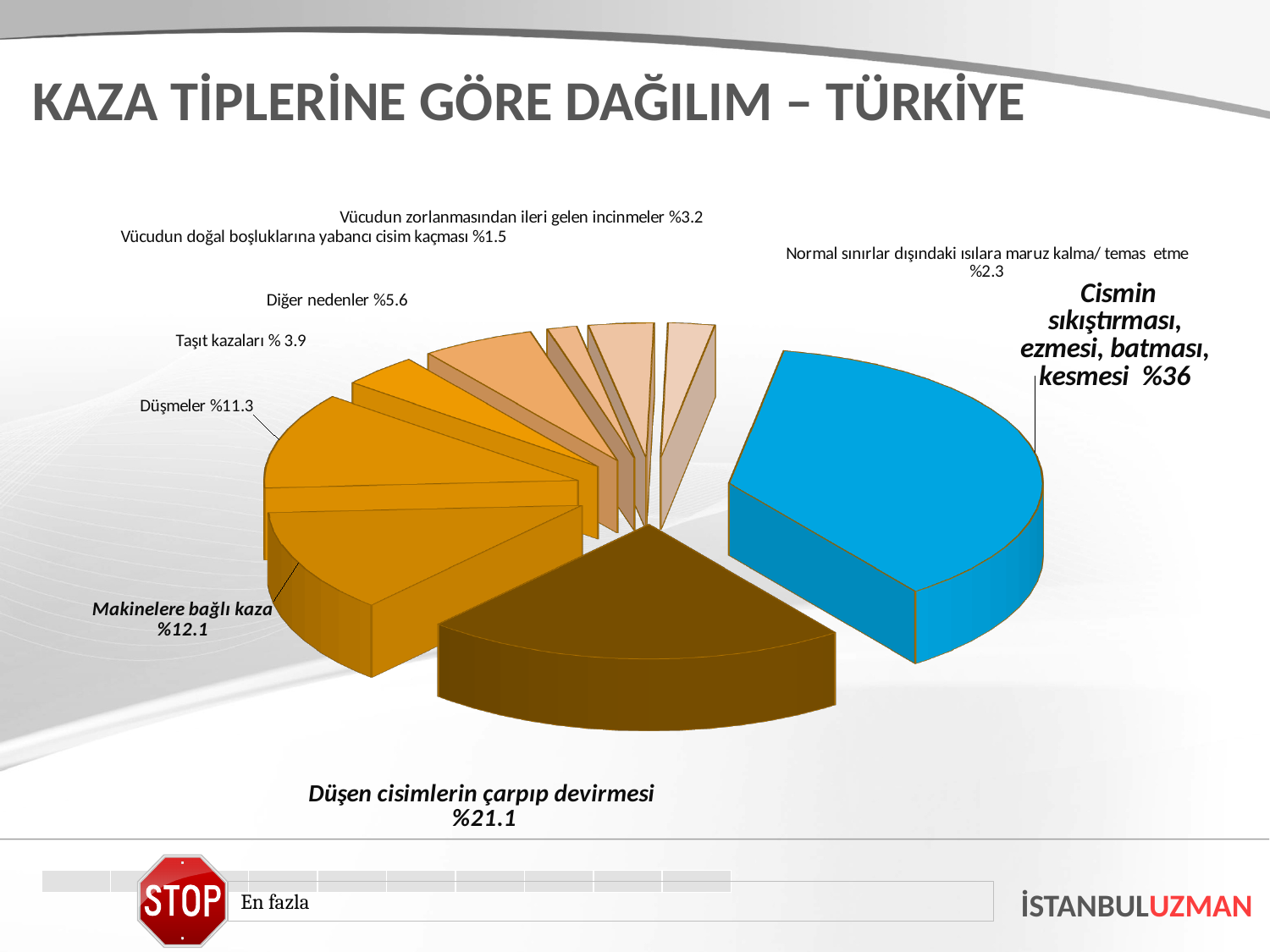
What type of chart is shown on the slide? Pie chart What is the value shown for 'Makinelere bağlı kaza'? %12.1 Which category has the largest share of the pie? Cismin sıkıştırması, ezmesi, batması, kesmesi What share of the pie does the slice 'Cismin sıkıştırması, ezmesi, batması, kesmesi' represent? %36 What is the value shown for 'Diğer nedenler'? %5.6 What is the value shown for 'Düşen cisimlerin çarpıp devirmesi'? %21.1 Which labelled category has the smallest share of the pie? Vücudun doğal boşluklarına yabancı cisim kaçması What is the value shown for 'Düşmeler'? %11.3 What is the value shown for 'Taşıt kazaları'? % 3.9 What is the value shown for 'Vücudun doğal boşluklarına yabancı cisim kaçması'? %1.5 What is the difference between the shares of 'Cismin sıkıştırması, ezmesi, batması, kesmesi' and 'Düşen cisimlerin çarpıp devirmesi'? 14.9 percentage points Which is larger, the share for 'Düşmeler' or the share for 'Makinelere bağlı kaza'? Makinelere bağlı kaza